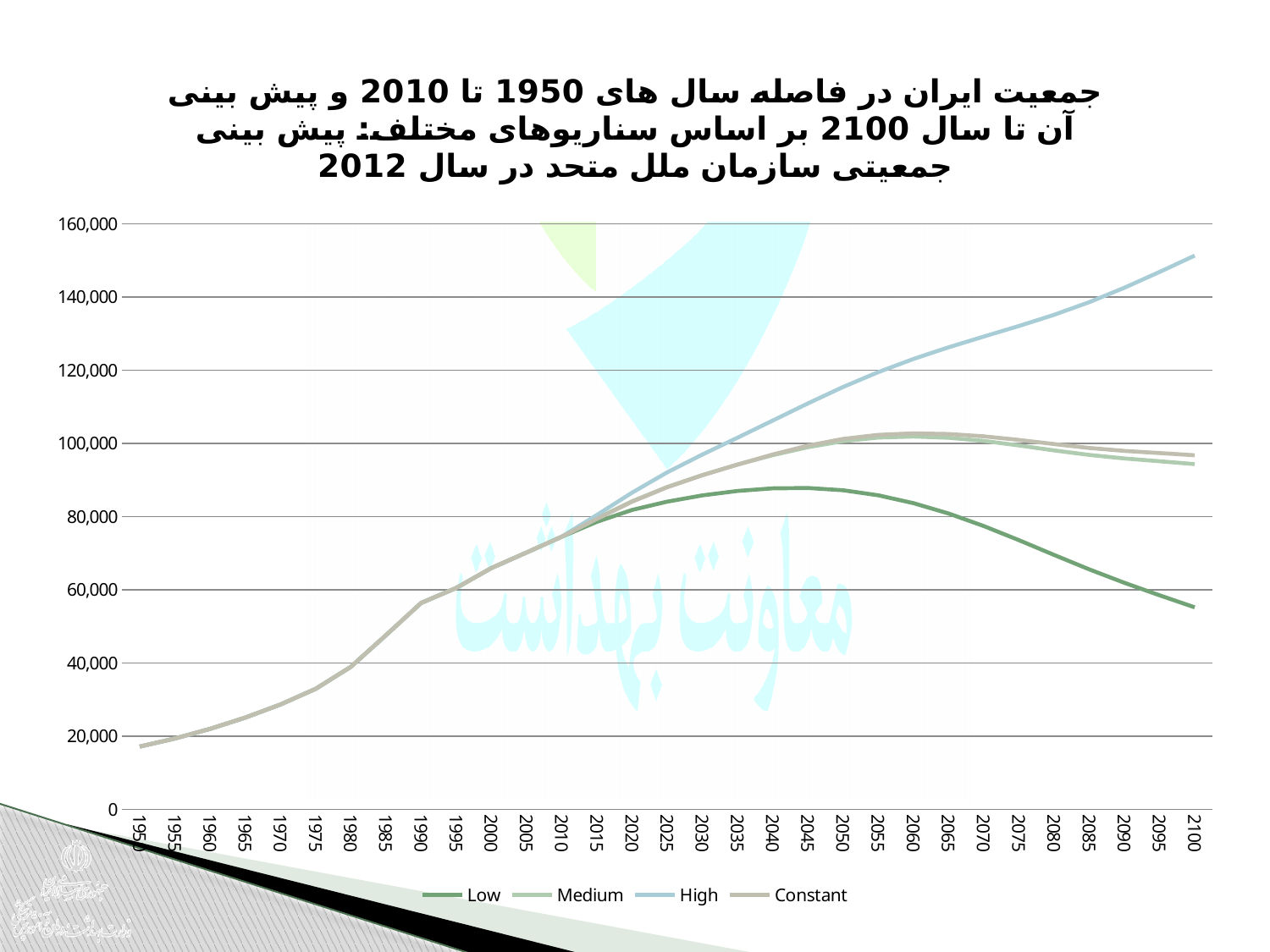
Which series are listed in the legend? Low, Medium, High, Constant How many year labels are shown along the x axis? 31 What kind of chart is shown on the slide? line chart Does the High series rise or fall from 2015 to 2100? rise Is the population value in 1950 greater or less than 20,000? less Is the value of the High series in 2100 greater or less than 140,000? greater Which series has the lowest value in 2100? Low Is the value of the High series in 2050 greater or less than 100,000? greater Which series has the highest value in 2100? High Which is larger in 2100, the High series or the Low series? High How many series does the legend list? 4